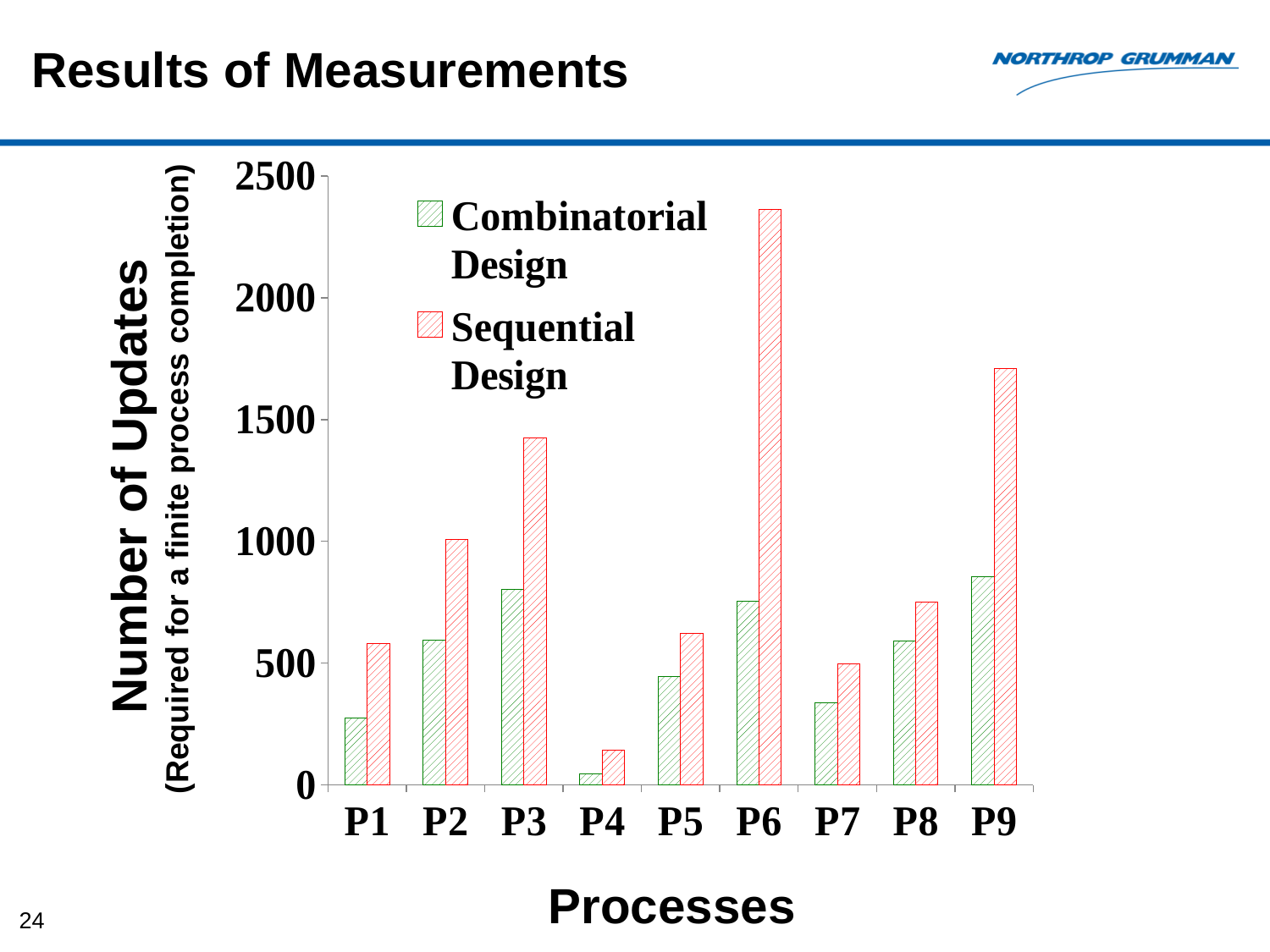
Is the Sequential Design value for P6 greater or less than 2000? greater How many series does the legend list? 2 Which process has the highest Sequential Design value? P6 What kind of chart is shown on the slide? bar chart Which process has the lowest Combinatorial Design value? P4 How many processes are shown on the x axis? 9 Is the Sequential Design value for P9 greater or less than 1500? greater Is the Sequential Design value for P3 greater or less than 1500? less What is the label of the x axis? Processes For P3, which is larger: the Combinatorial Design value or the Sequential Design value? Sequential Design Which process has the lowest Sequential Design value? P4